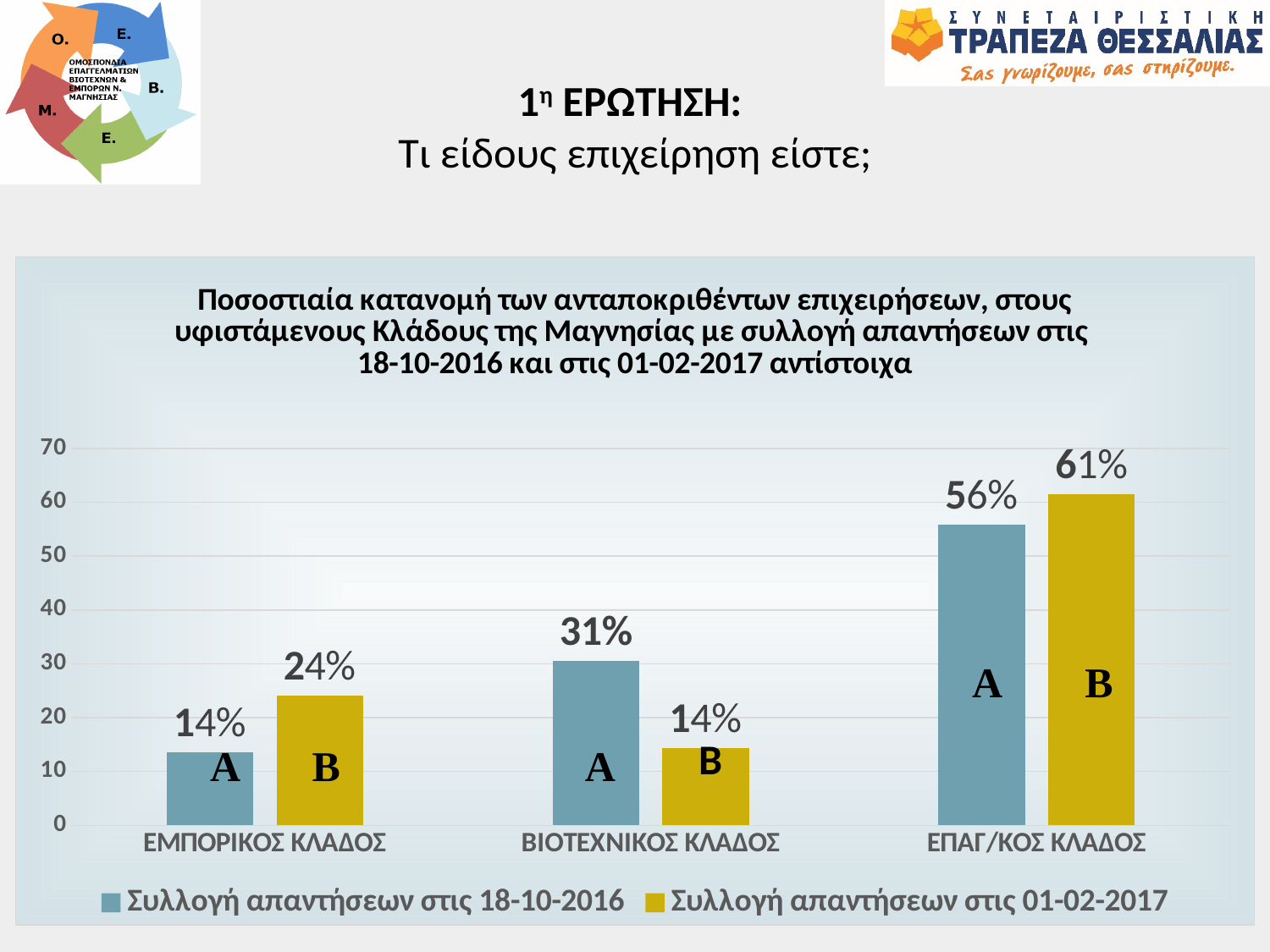
What kind of chart is shown on the slide? bar chart How many categories are shown on the x axis of the chart? 3 Which category has the highest value in the series Συλλογή απαντήσεων στις 18-10-2016? ΕΠΑΓ/ΚΟΣ ΚΛΑΔΟΣ Which category has the lowest value in the series Συλλογή απαντήσεων στις 01-02-2017? ΒΙΟΤΕΧΝΙΚΟΣ ΚΛΑΔΟΣ Is the value for ΕΠΑΓ/ΚΟΣ ΚΛΑΔΟΣ in the 18-10-2016 series greater or less than 50? greater How many series does the legend list? 2 What is the value for ΕΜΠΟΡΙΚΟΣ ΚΛΑΔΟΣ in the series Συλλογή απαντήσεων στις 01-02-2017? 24% For ΒΙΟΤΕΧΝΙΚΟΣ ΚΛΑΔΟΣ, which series has the larger value: 18-10-2016 or 01-02-2017? Συλλογή απαντήσεων στις 18-10-2016 What is the difference between the 01-02-2017 and 18-10-2016 values for ΕΠΑΓ/ΚΟΣ ΚΛΑΔΟΣ? 5% What is the value for ΕΜΠΟΡΙΚΟΣ ΚΛΑΔΟΣ in the series Συλλογή απαντήσεων στις 18-10-2016? 14% What is the value for ΒΙΟΤΕΧΝΙΚΟΣ ΚΛΑΔΟΣ in the series Συλλογή απαντήσεων στις 18-10-2016? 31% What is the value for ΕΠΑΓ/ΚΟΣ ΚΛΑΔΟΣ in the series Συλλογή απαντήσεων στις 01-02-2017? 61%